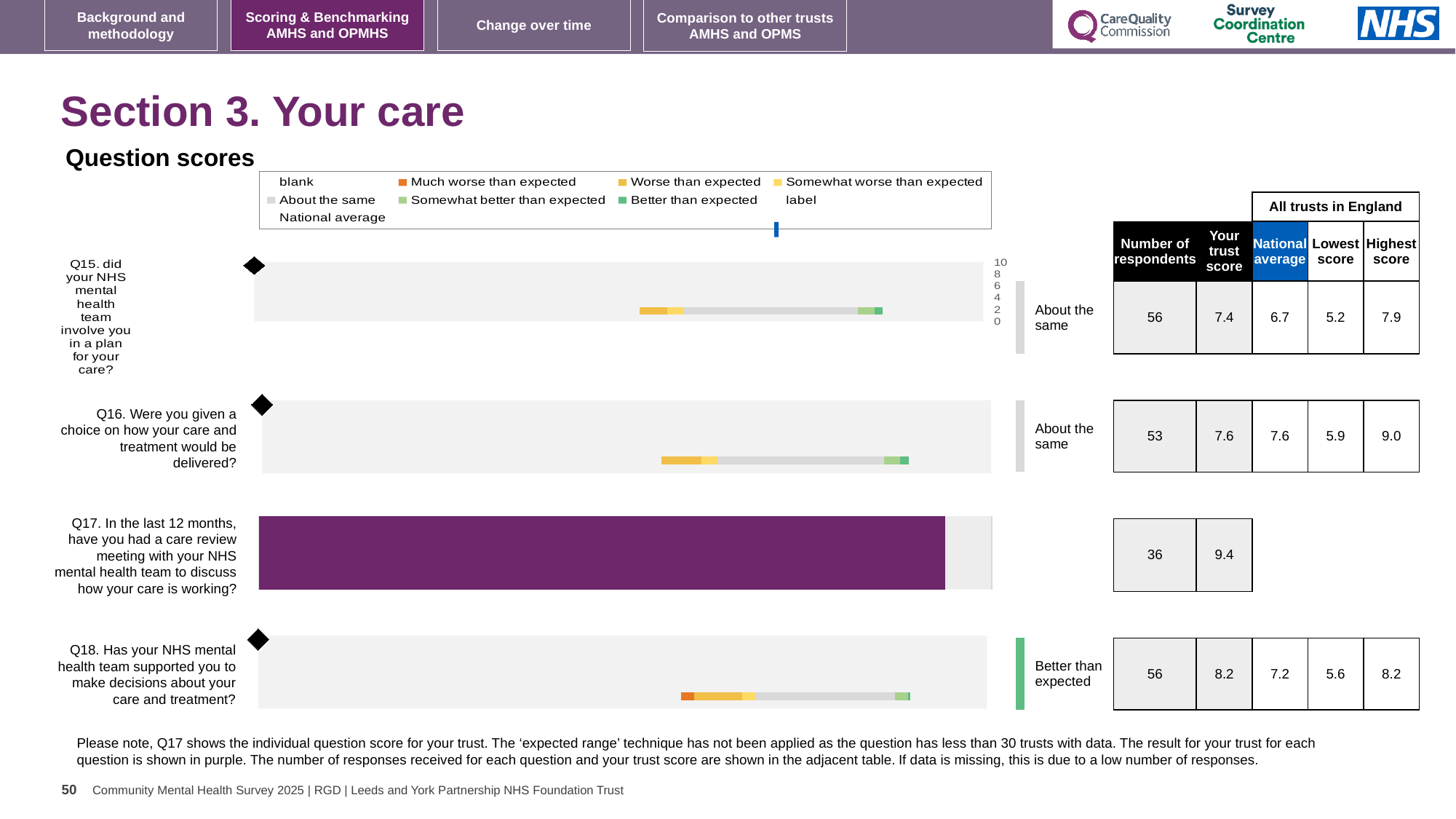
Which question has the highest trust score on this slide? Q17 For Q15, which is larger: the trust score or the national average? The trust score Which question's result is labelled 'Better than expected'? Q18 What is the trust score for Q18 (Has your NHS mental health team supported you to make decisions about your care and treatment?)? 8.2 What is the lowest score among all trusts in England for Q18? 5.6 How many questions are plotted in the chart? 4 Which question has the lowest number of respondents? Q17 What kind of chart is used to show the question scores? Bar chart How many respondents are shown for Q16 in the table next to the chart? 53 What is the difference between the trust score and the national average for Q18? 1.0 What is the highest score among all trusts in England for Q16? 9.0 What is the national average for Q15 (did your NHS mental health team involve you in a plan for your care?)? 6.7